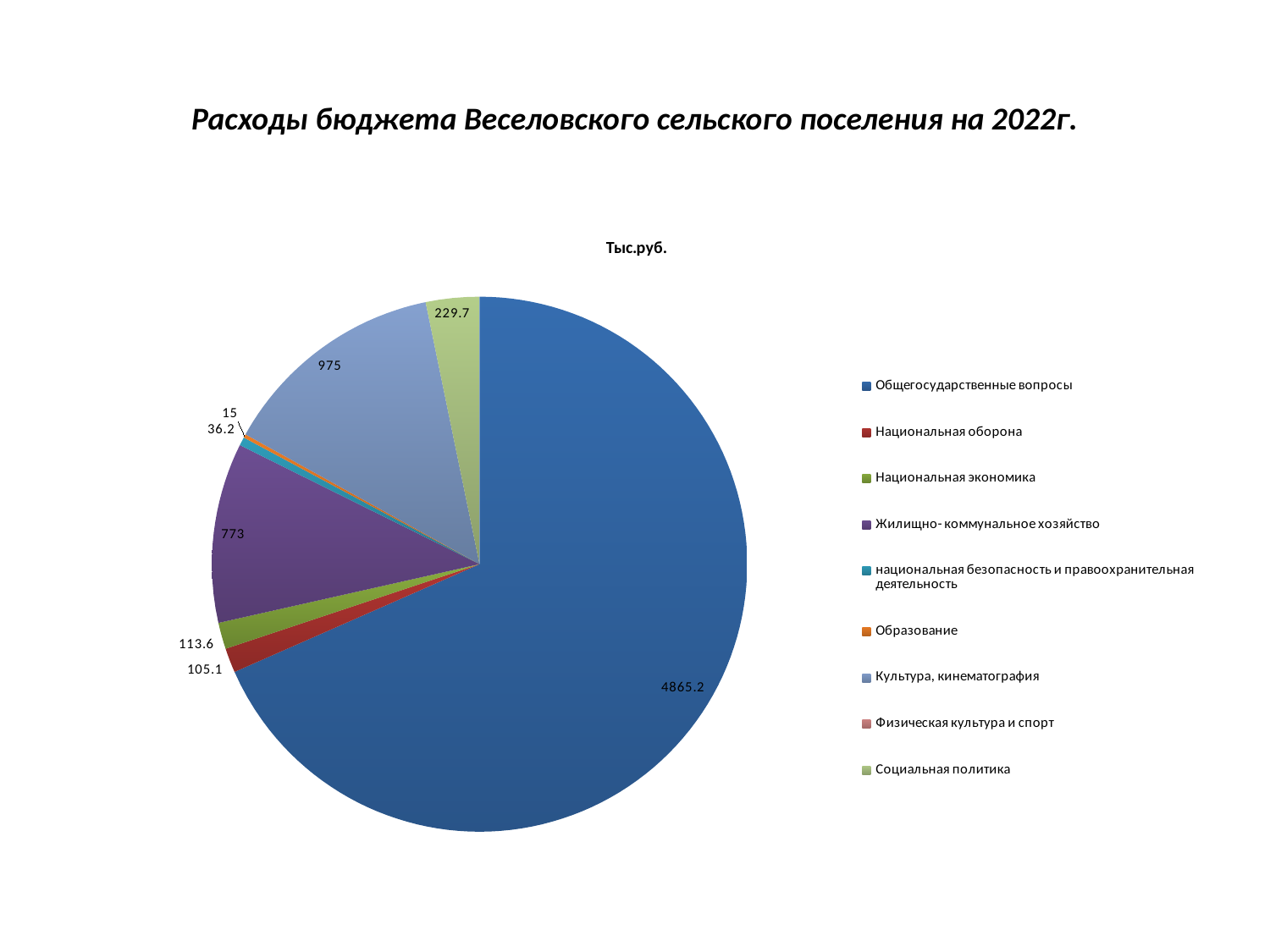
What is the value for Общегосударственные вопросы? 4865.2 What is the difference between the values for Культура, кинематография and Жилищно- коммунальное хозяйство? 202 How many categories does the legend list? 9 What is the value for национальная безопасность и правоохранительная деятельность? 36.2 What is the value for Образование? 15 What is the value for Культура, кинематография? 975 What is the value for Жилищно- коммунальное хозяйство? 773 Which category has the largest slice of the pie? Общегосударственные вопросы What kind of chart is shown on the slide? pie chart Which is larger: the value for Социальная политика or the value for Национальная экономика? Социальная политика What is the title shown above the pie chart? Тыс.руб. What is the value for Социальная политика? 229.7